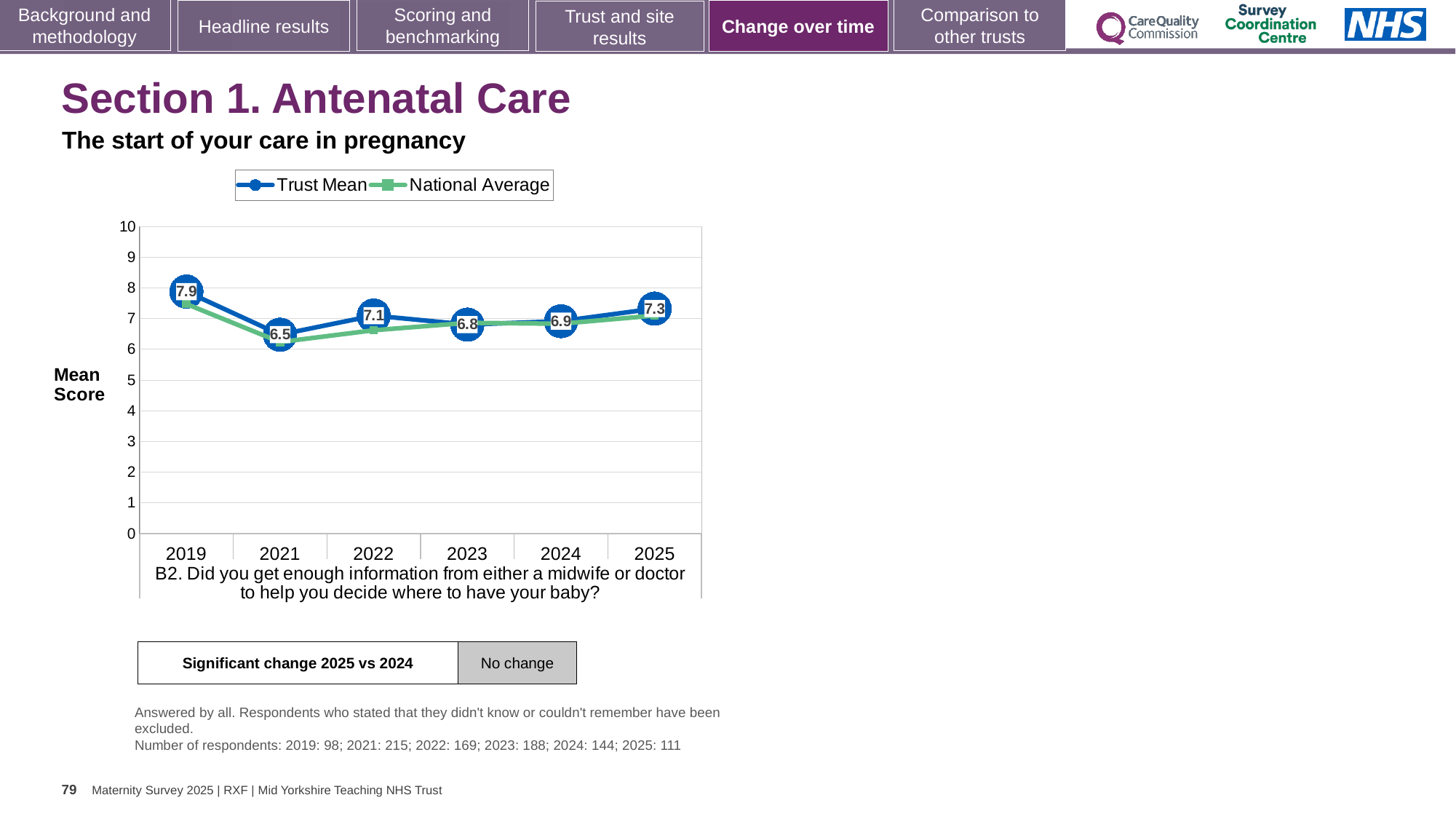
Is the National Average for 2021 greater or less than 7? less What is the Trust Mean for 2021? 6.5 In which year is the Trust Mean lowest? 2021 What is the difference between the Trust Mean in 2019 and in 2021? 1.4 What is the Trust Mean for 2023? 6.8 In which year is the Trust Mean highest? 2019 How many years are shown on the x axis? 6 What is the Trust Mean for 2025? 7.3 Which year has the larger Trust Mean, 2022 or 2024? 2022 How many series does the legend list? 2 What kind of chart is shown on the slide? line chart What is the Trust Mean for 2019? 7.9